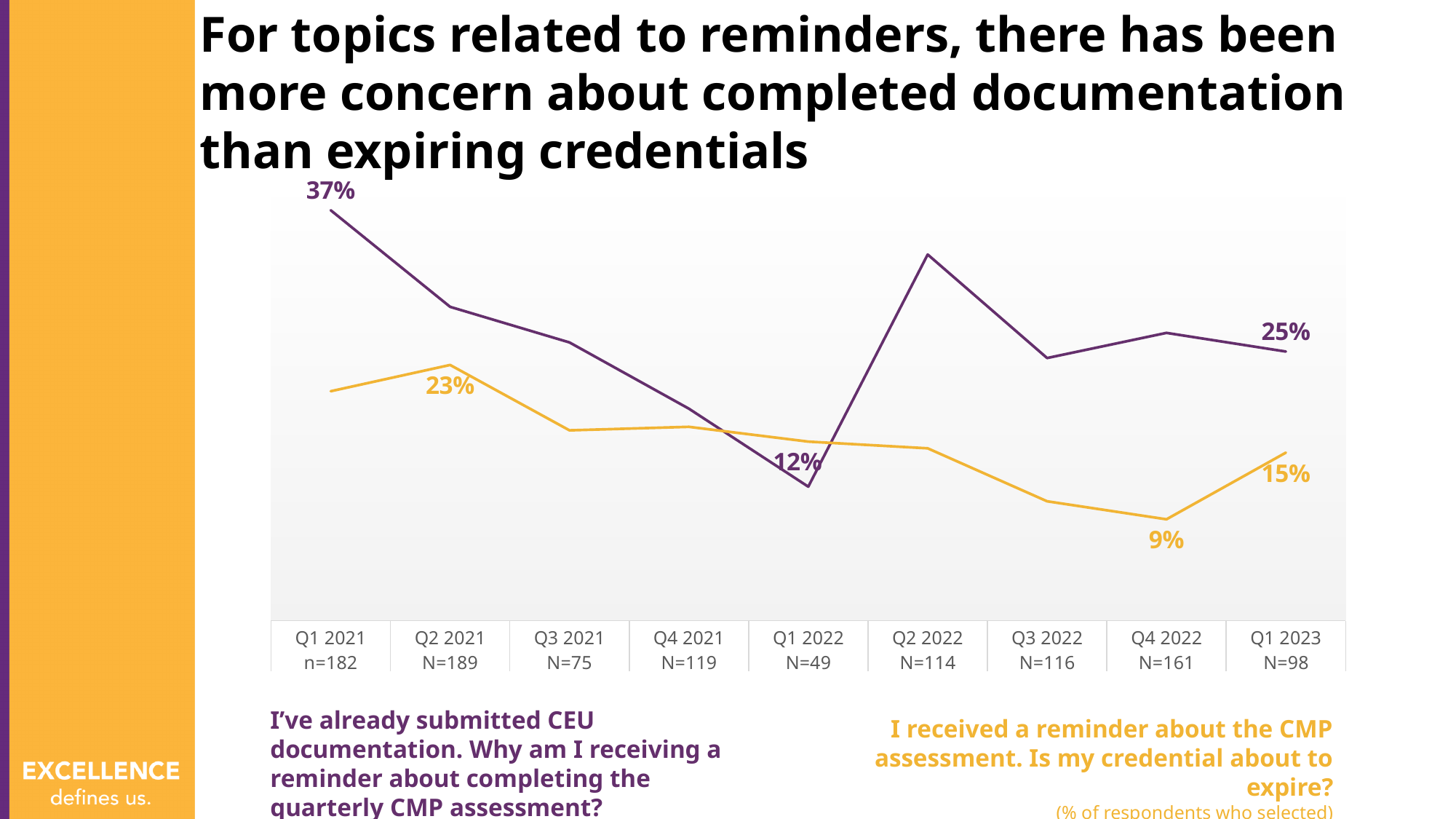
By how many percentage points did the purple line (CEU documentation reminder question) fall from Q1 2021 to Q1 2023? 12 percentage points How many quarters are shown on the x axis of the chart? 9 What value does the yellow line (credential about to expire question) show for Q4 2022? 9% In which quarter does the purple line (CEU documentation reminder question) reach its highest value? Q1 2021 What value does the purple line (CEU documentation reminder question) show for Q1 2023? 25% In Q1 2023, which question had the higher share of respondents: the CEU documentation reminder question or the credential about to expire question? The CEU documentation reminder question What type of chart is shown on the slide? Line chart In which quarter does the yellow line (credential about to expire question) reach its lowest value? Q4 2022 What percentage of respondents selected "I received a reminder about the CMP assessment. Is my credential about to expire?" in Q2 2021? 23% What value does the yellow line (credential about to expire question) show for Q1 2023? 15% What value does the purple line (CEU documentation reminder question) show for Q1 2022? 12% What percentage of respondents selected "I've already submitted CEU documentation. Why am I receiving a reminder about completing the quarterly CMP assessment?" in Q1 2021? 37%